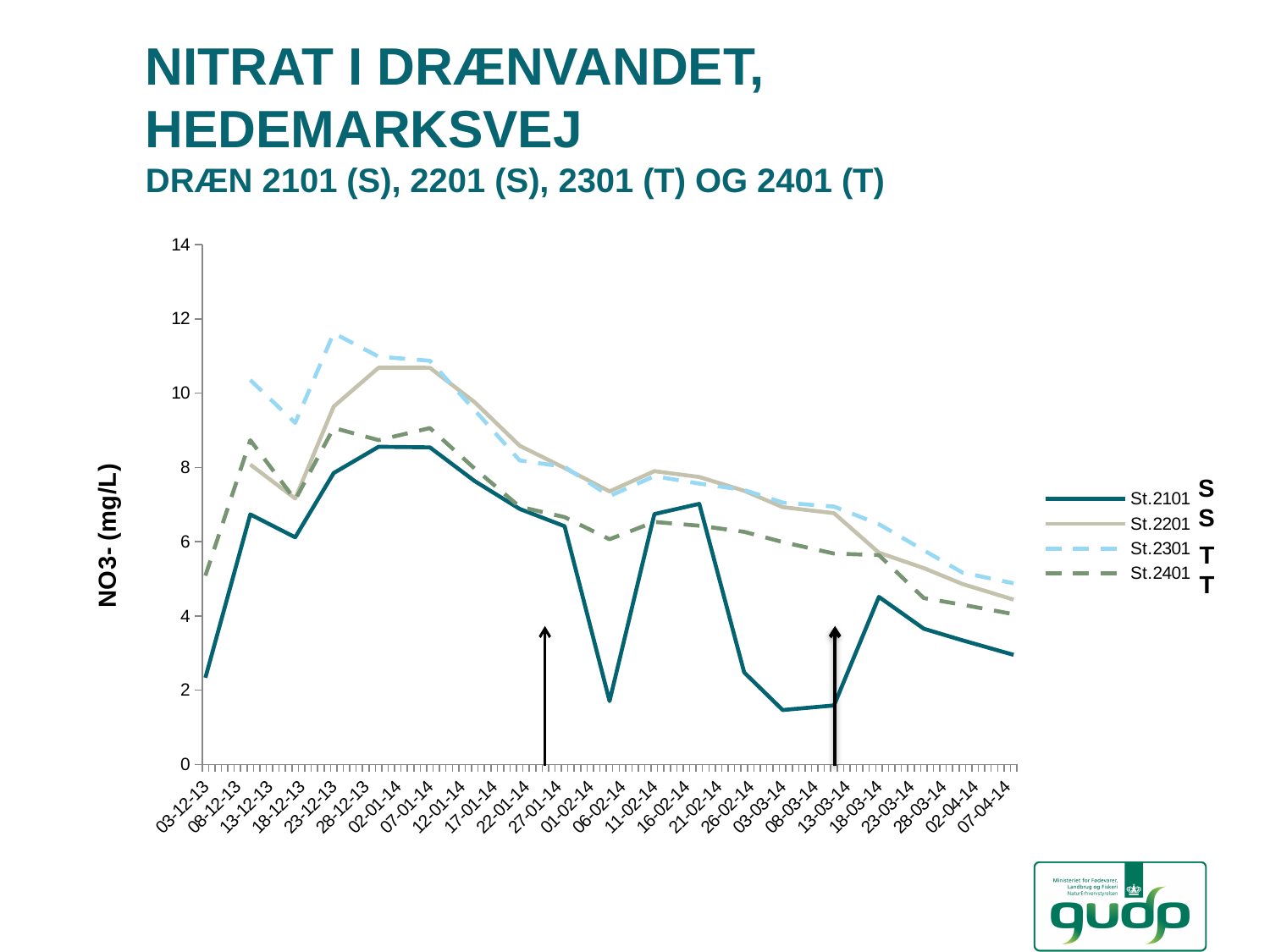
Does the St.2201 series rise or fall overall from 07-01-14 to 07-04-14? fall Is the value for St.2401 at 07-04-14 greater or less than 6? less Which series is drawn as a solid dark teal line? St.2101 What kind of chart is shown on the slide? line chart Which series has the highest value around 23-12-13? St.2301 Is the value for St.2301 at 23-12-13 greater or less than 10? greater Is the value for St.2101 at 06-02-14 greater or less than 4? less Which series has the lowest value at 06-02-14? St.2101 Which series has the lowest value at 03-03-14? St.2101 What is the label of the vertical axis? NO3- (mg/L) How many series does the legend list? 4